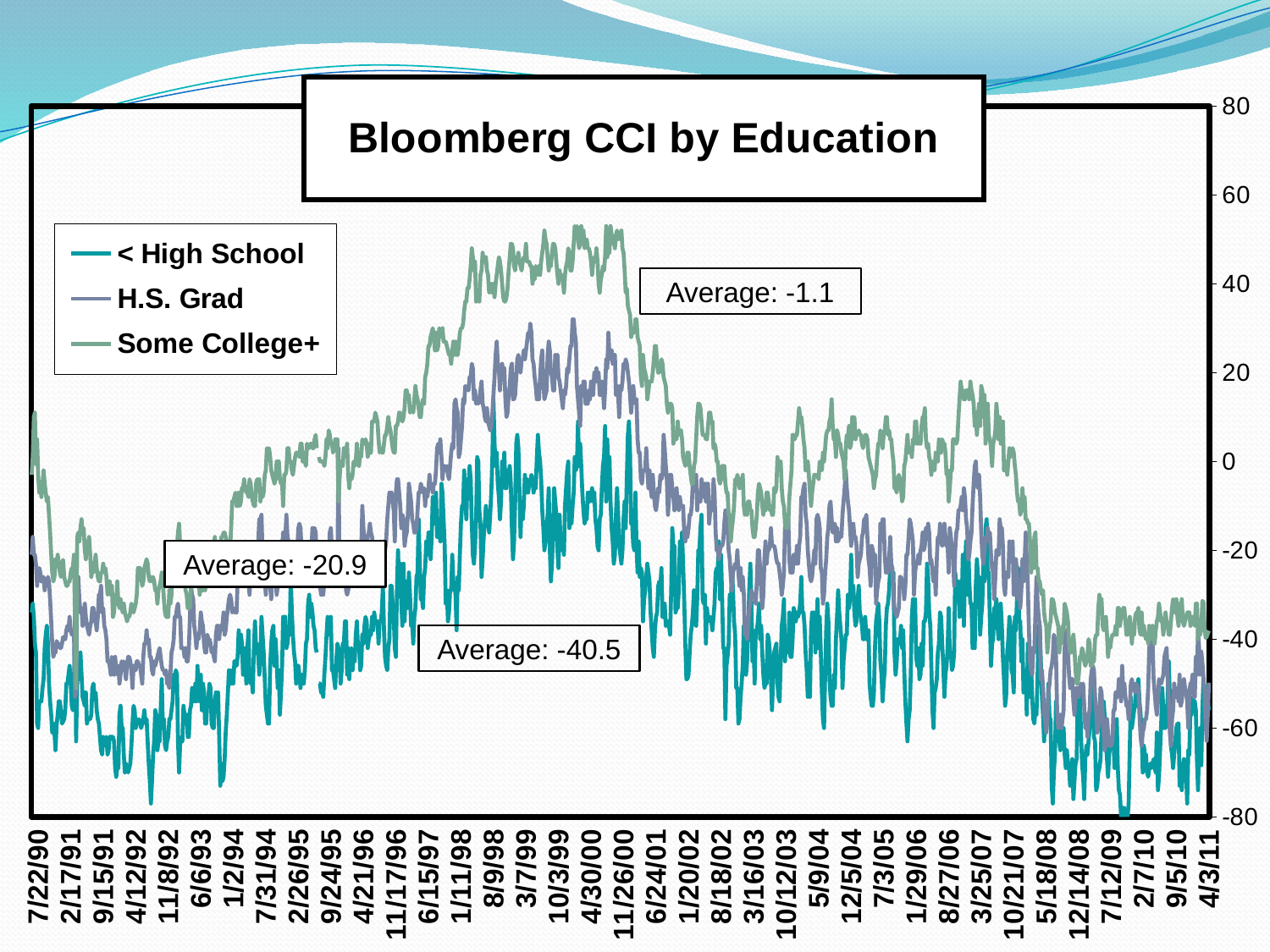
What kind of chart is shown on the slide? Line chart What average value is annotated for the H.S. Grad series? -20.9 Is the peak value of the Some College+ series around 10/3/99 greater or less than 40? greater Which education group has the highest annotated average? Some College+ What is the difference between the annotated averages for Some College+ and < High School? 39.4 Which education group has the lowest annotated average? < High School How many series does the legend list? 3 Do the values of all three series rise or fall between 3/25/07 and 12/14/08? fall What average value is annotated for the < High School series? -40.5 Is the value of the < High School series at the end of the chart (around 4/3/11) greater or less than -40? less What is the title of the chart? Bloomberg CCI by Education What average value is annotated for the Some College+ series? -1.1